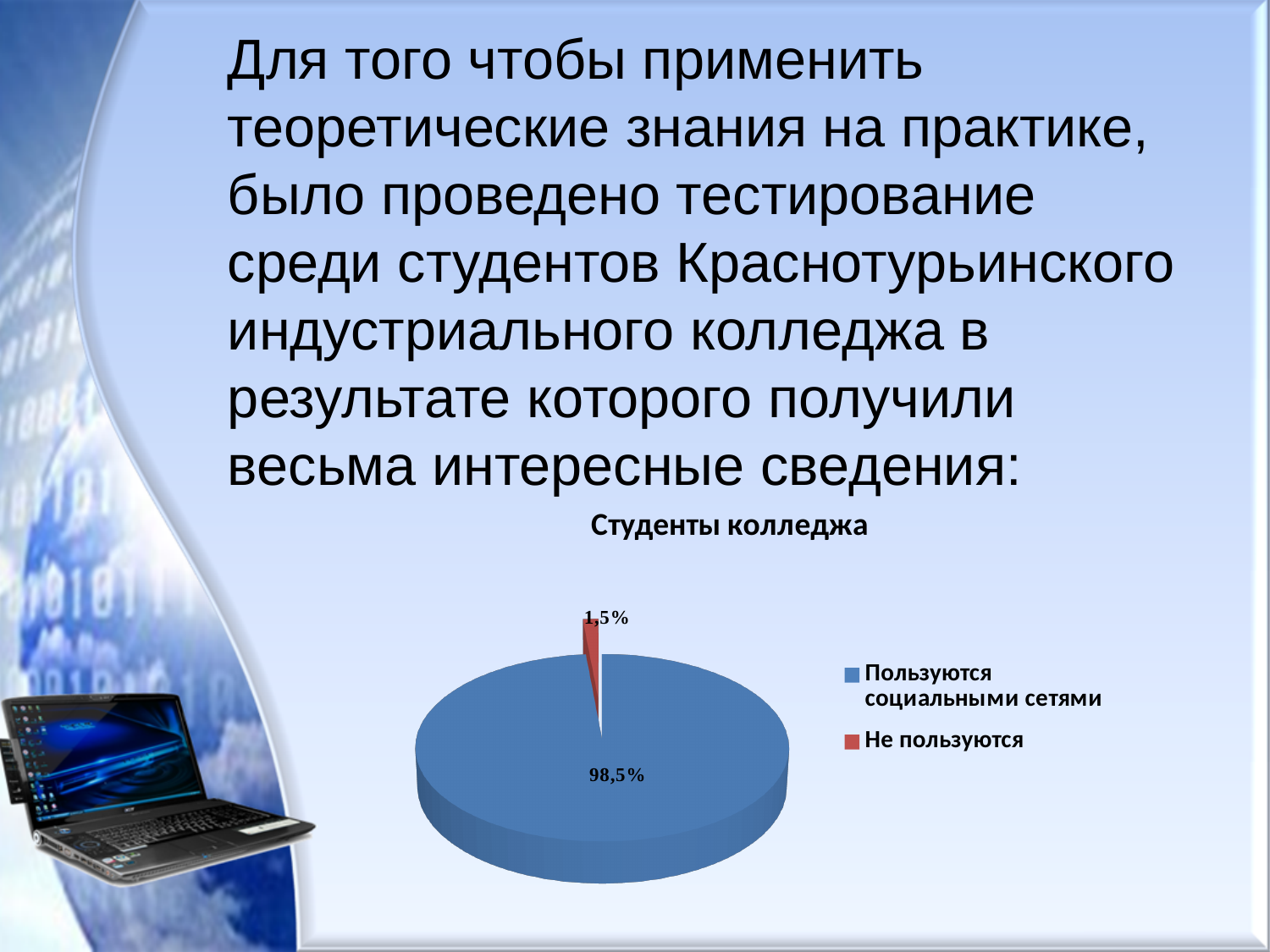
What share of the pie is labelled "Пользуются социальными сетями"? 98,5% How many categories does the legend list? 2 What is the total of the two slices shown in the pie? 100% What share of the pie is labelled "Не пользуются"? 1,5% What colour is the slice for "Не пользуются"? red Which is larger: the share for "Пользуются социальными сетями" or the share for "Не пользуются"? Пользуются социальными сетями Which category has the smallest slice of the pie? Не пользуются Which category has the largest slice of the pie? Пользуются социальными сетями What is the title of the chart? Студенты колледжа What is the difference between the share for "Пользуются социальными сетями" and the share for "Не пользуются"? 97% What kind of chart is shown on the slide? pie chart